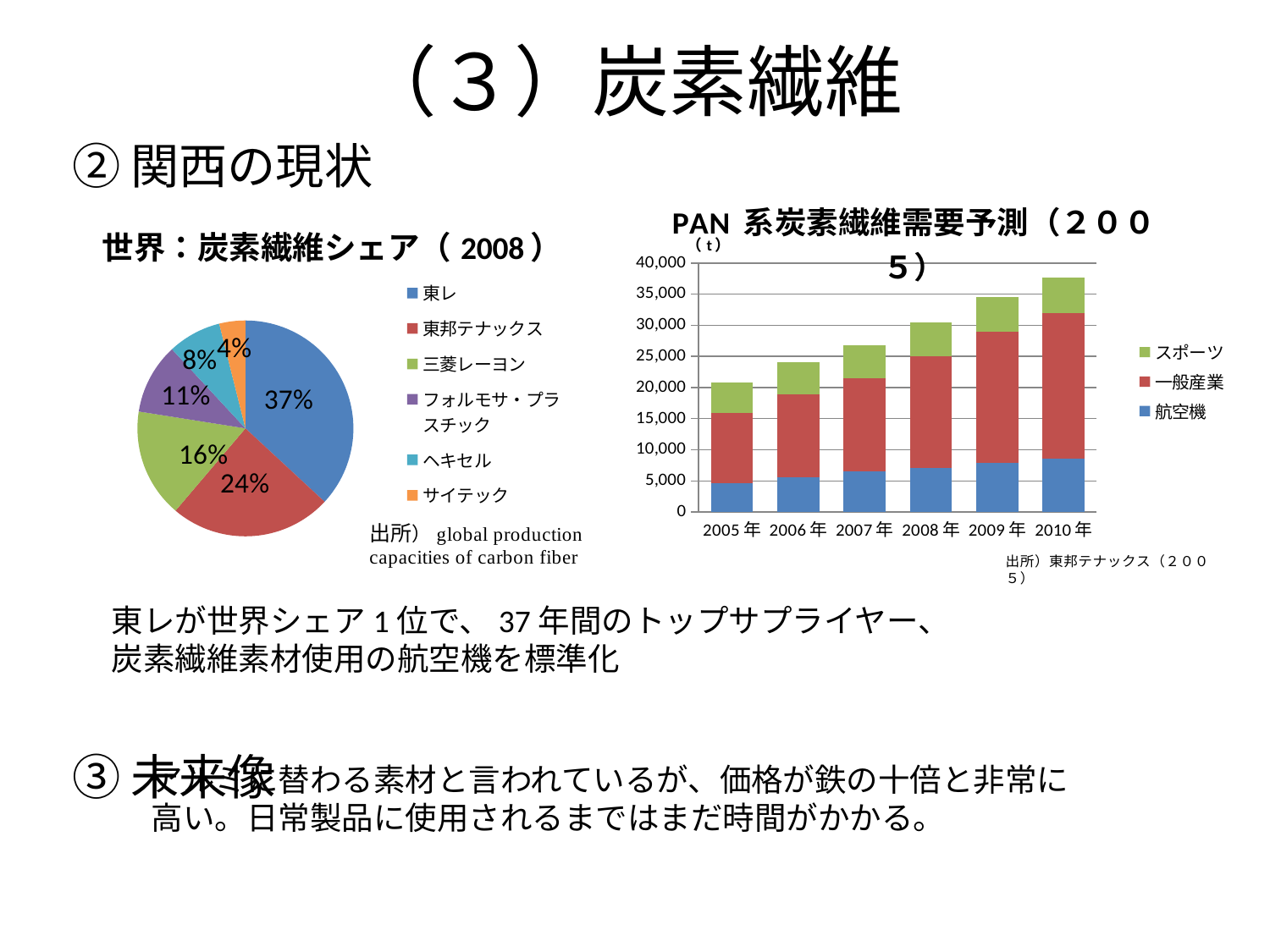
In the pie chart 世界：炭素繊維シェア（2008）, what share does 東レ hold? 37% In the pie chart 世界：炭素繊維シェア（2008）, what is the difference in percentage points between 東レ and 三菱レーヨン? 21 In the PAN系炭素繊維需要予測 chart, is the total for 2010年 greater or less than 35,000? greater In the pie chart 世界：炭素繊維シェア（2008）, which has the larger share, フォルモサ・プラスチック or ヘキセル? フォルモサ・プラスチック How many series does the legend of the PAN系炭素繊維需要予測 chart list? 3 What kind of chart is the chart on the right, PAN系炭素繊維需要予測? Stacked bar chart In the pie chart 世界：炭素繊維シェア（2008）, what share does ヘキセル hold? 8% In the pie chart 世界：炭素繊維シェア（2008）, which company has the largest share? 東レ In the pie chart 世界：炭素繊維シェア（2008）, which company has the smallest share? サイテック In the pie chart 世界：炭素繊維シェア（2008）, what share does 東邦テナックス hold? 24% In the PAN系炭素繊維需要予測 chart, do the total bar heights rise or fall from 2005年 to 2010年? Rise How many companies are shown in the pie chart 世界：炭素繊維シェア（2008）? 6